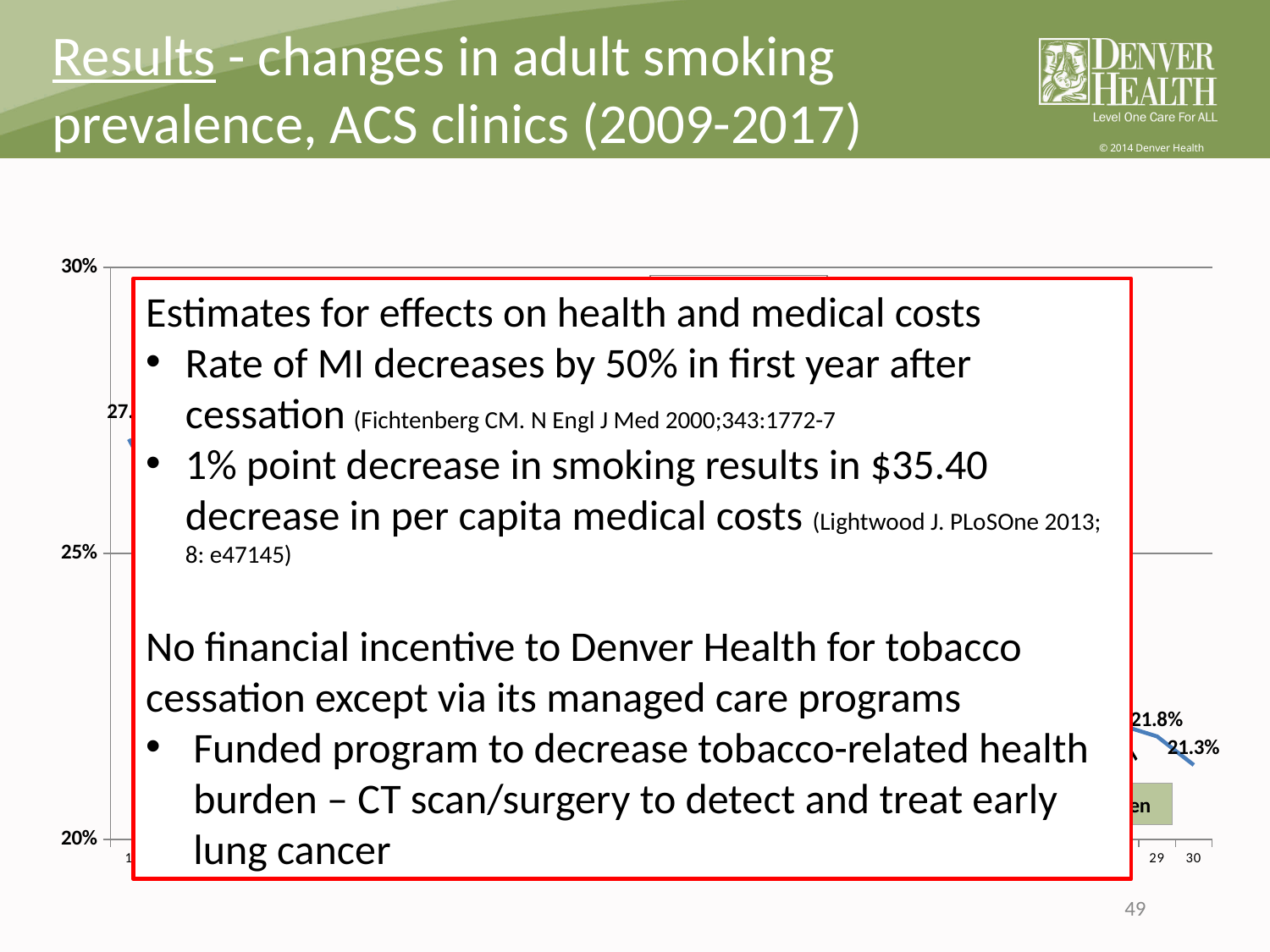
Is the final value of the line (21.3%) greater or less than 25%? less Does the line rise or fall between the 21.8% label and the 21.3% label at the right end of the chart? fall Of the two data labels visible at the right end of the line, 21.8% and 21.3%, which is larger? 21.8% What kind of chart is shown on the slide? line chart What data label appears just before the final 21.3% label at the right end of the line? 21.8% What is the last x-axis tick label visible on the chart? 30 What is the last data label shown at the right end of the line? 21.3% What is the difference between the two data labels visible at the right end of the line, 21.8% and 21.3%? 0.5% What is the lowest value shown on the chart's y-axis? 20% What is the highest value shown on the chart's y-axis? 30%